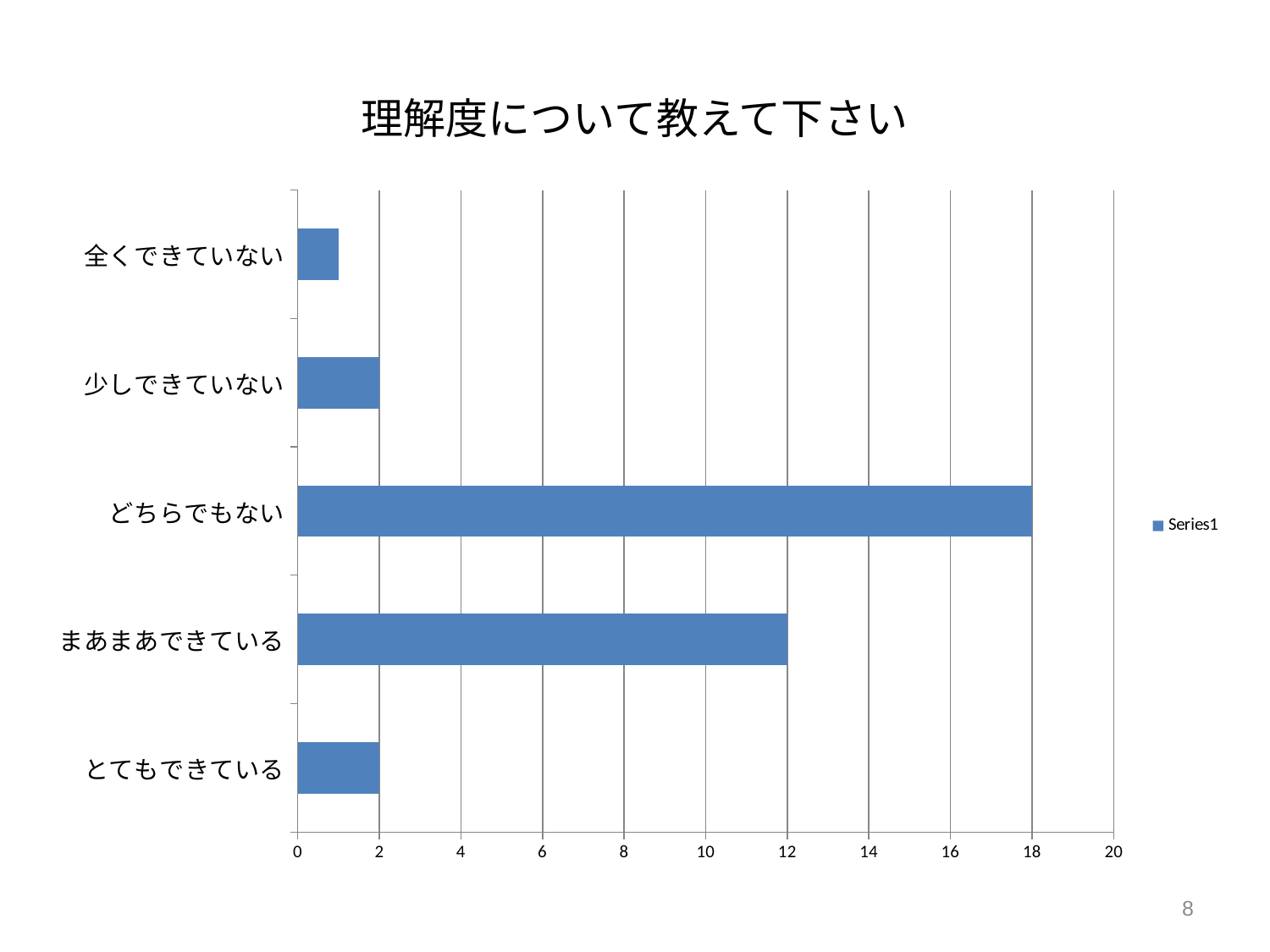
What is the value for どちらでもない? 18 What is the difference between the values for どちらでもない and まあまあできている? 6 What type of chart is shown on the slide? bar chart Is the value for 全くできていない greater or less than 2? less What is the value for 少しできていない? 2 What is the title of the chart? 理解度について教えて下さい Which category has the highest value? どちらでもない How many series does the legend list? 1 What is the value for とてもできている? 2 Which category has the lowest value? 全くできていない How many categories are shown on the chart? 5 What is the value for まあまあできている? 12